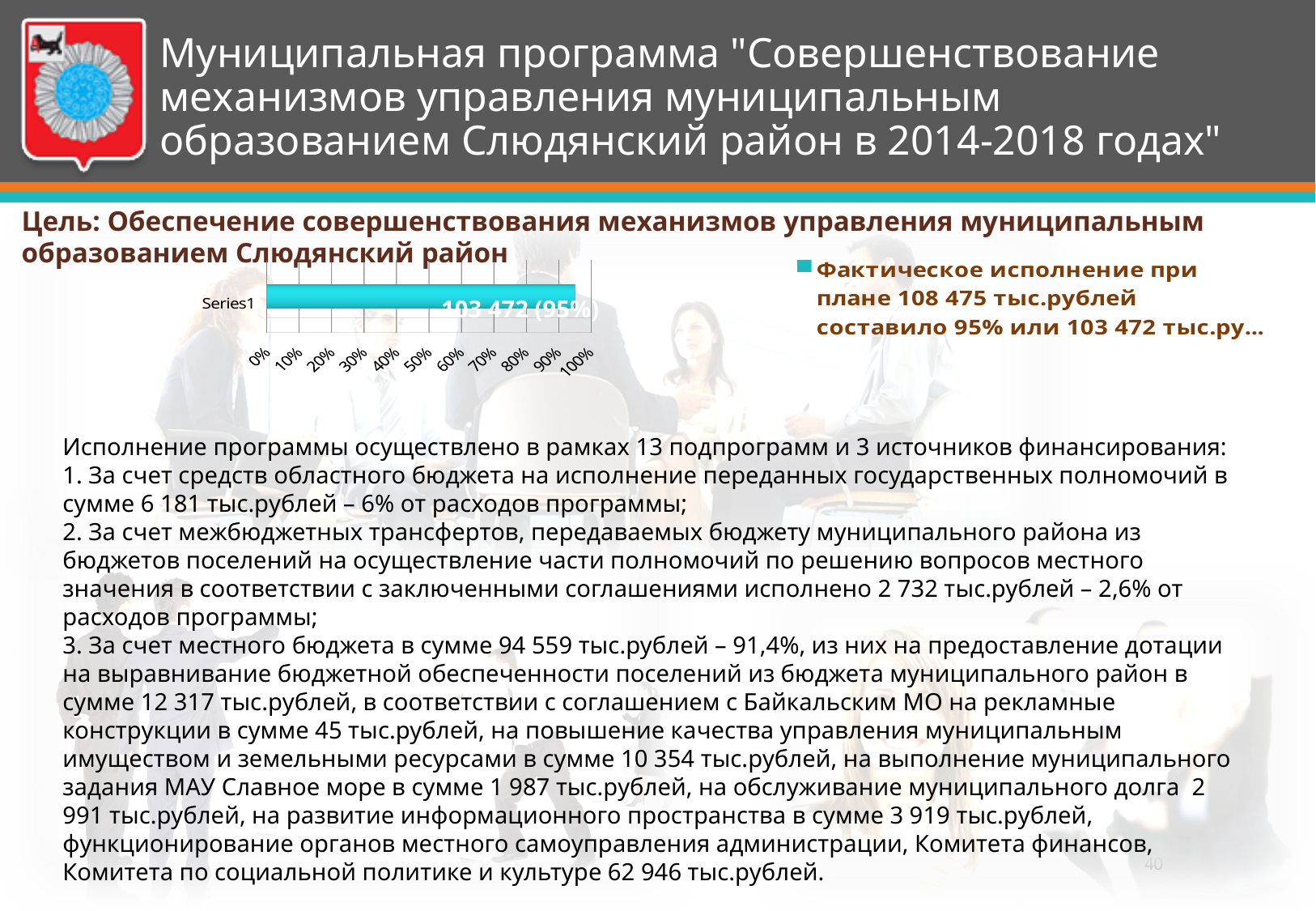
Is the value of the Series1 bar greater or less than 100%? less What kind of chart is shown on the slide? bar chart What is the category label shown on the vertical axis of the chart? Series1 What percentage is shown in the data label on the bar? 95% What is the highest tick value shown on the horizontal axis of the chart? 100% Is the value of the Series1 bar greater or less than 90%? greater How many bars are plotted in the chart? 1 How many series does the chart legend list? 1 What data label is printed on the bar for Series1? 103 472 (95%) According to the chart legend, what was the planned amount in thousand rubles? 108 475 тыс.рублей